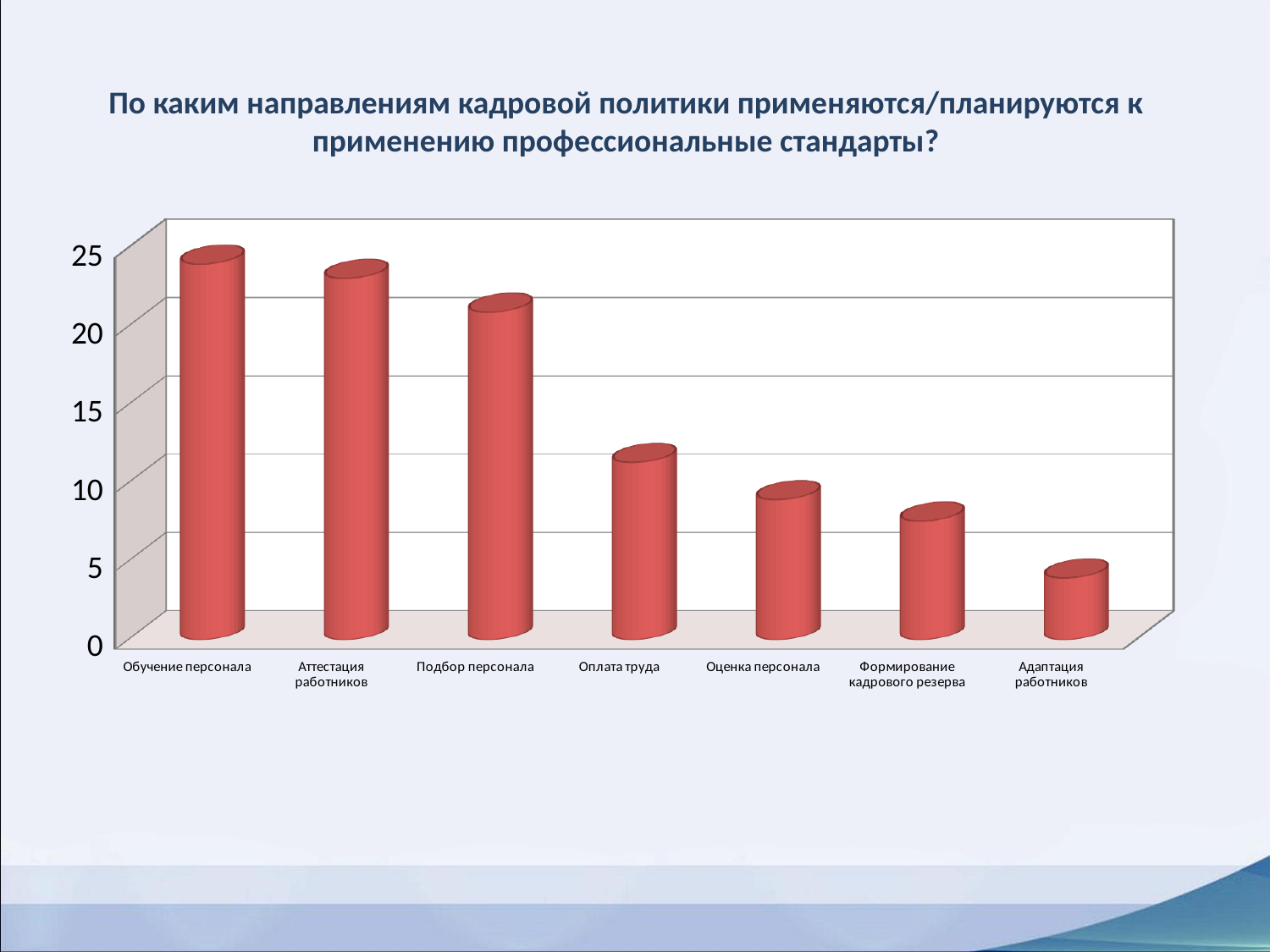
Is the value for Формирование кадрового резерва greater or less than 10? less What kind of chart is shown on the slide? bar chart How many categories are shown on the x axis of the chart? 7 Is the value for Подбор персонала greater or less than 15? greater Is the value for Аттестация работников greater or less than 20? greater What is the title of the chart on the slide? По каким направлениям кадровой политики применяются/планируются к применению профессиональные стандарты? Do the values rise or fall moving from left to right along the x axis? fall Which is larger, the value for Подбор персонала or the value for Оплата труда? Подбор персонала Which category has the lowest value in the chart? Адаптация работников